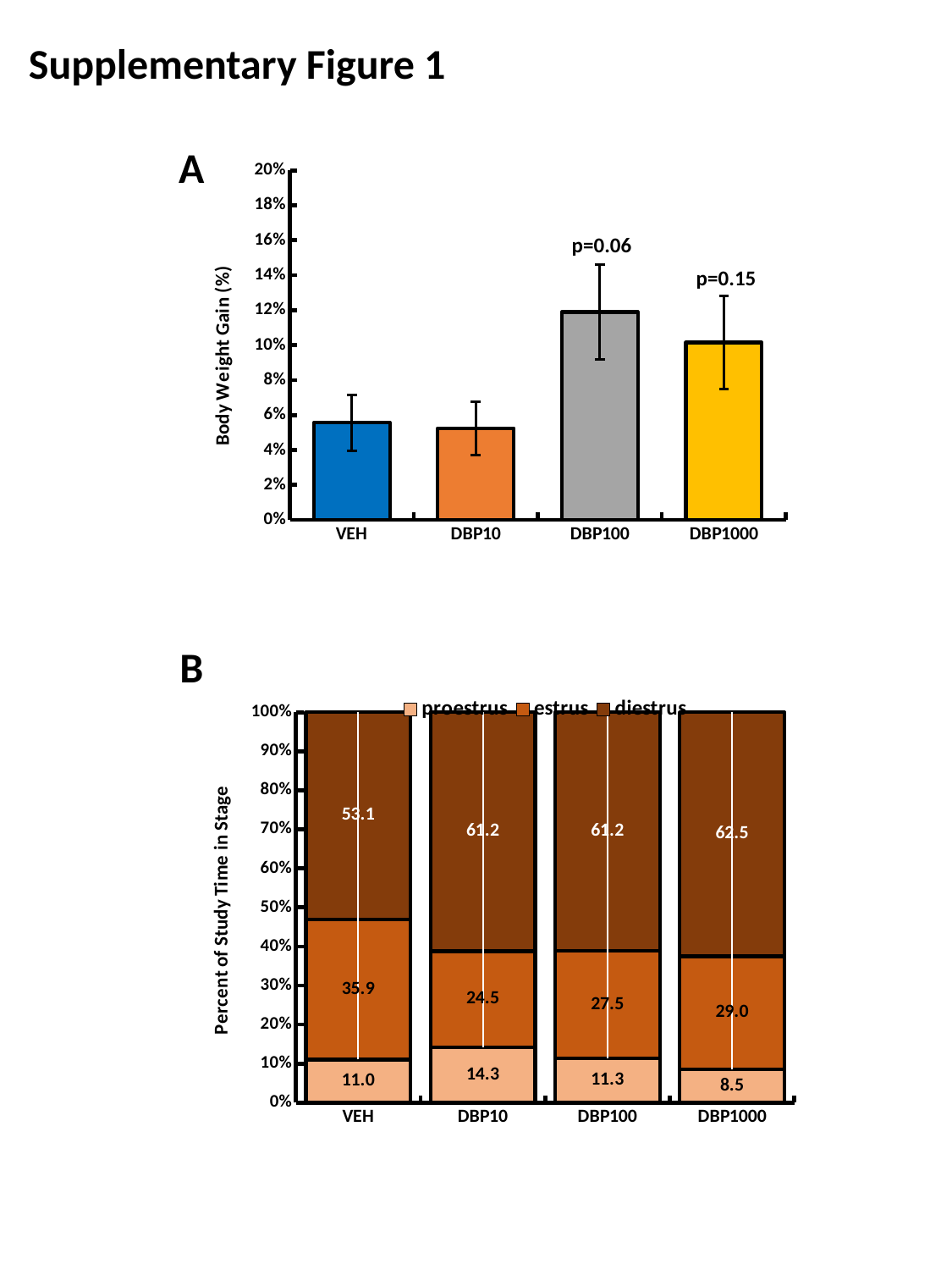
In chart A (Body Weight Gain), which is larger, the value for DBP100 or the value for VEH? DBP100 In chart A (Body Weight Gain), is the value for VEH greater or less than 8%? less In chart B (Percent of Study Time in Stage), what is the difference between the estrus values for VEH and DBP10? 11.4 In chart B (Percent of Study Time in Stage), which group has the highest proestrus value? DBP10 In chart B (Percent of Study Time in Stage), what is the diestrus value for VEH? 53.1 In chart A (Body Weight Gain), what p-value is printed above the DBP100 bar? p=0.06 In chart B (Percent of Study Time in Stage), how many series does the legend list? 3 In chart A (Body Weight Gain), how many groups are shown on the x axis? 4 What kind of chart is chart B (Percent of Study Time in Stage)? stacked bar chart In chart A (Body Weight Gain), is the value for DBP100 greater or less than 10%? greater In chart A (Body Weight Gain), which group has the highest body weight gain? DBP100 In chart B (Percent of Study Time in Stage), what is the proestrus value for DBP1000? 8.5